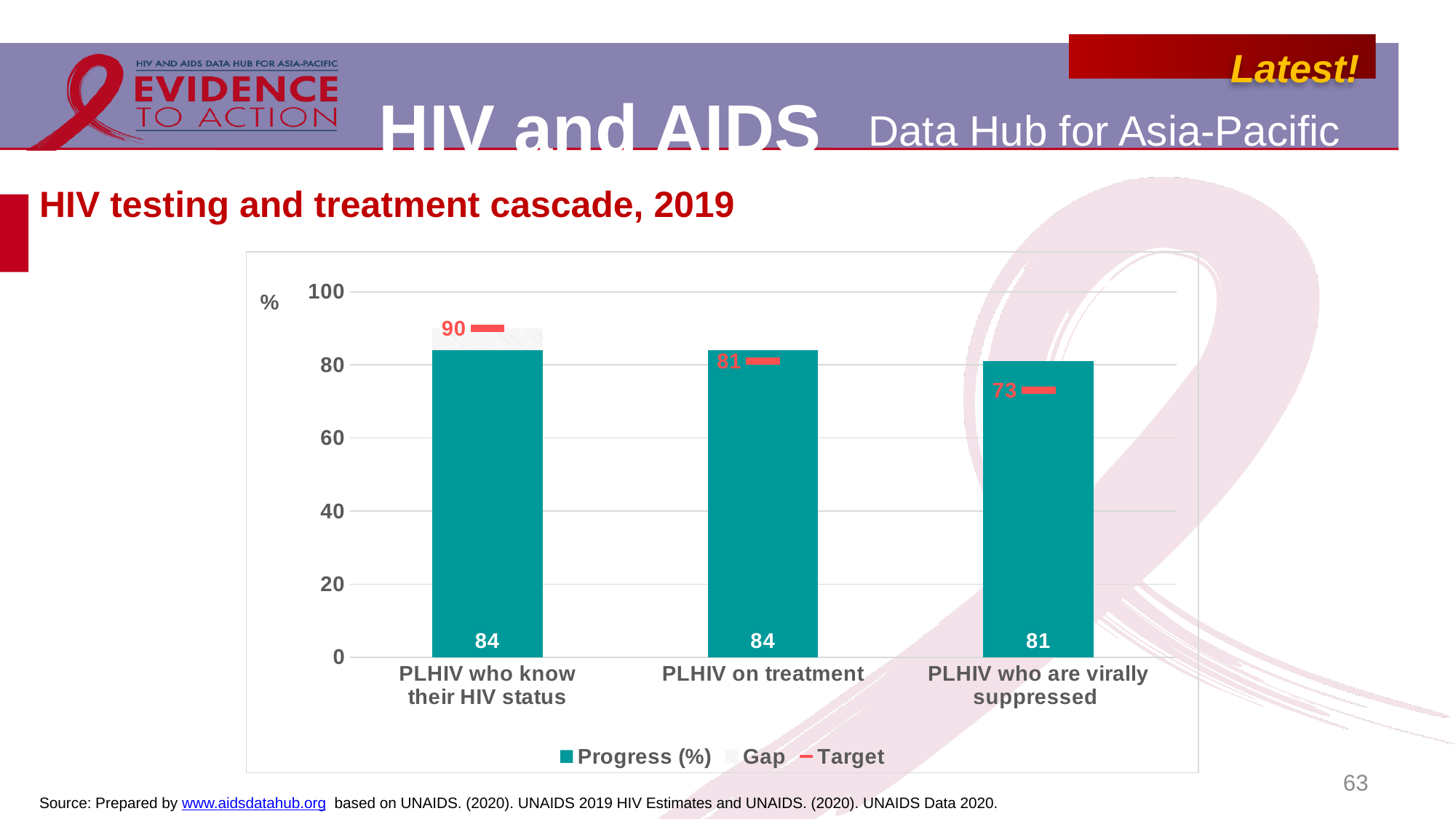
Is the Progress (%) value for PLHIV on treatment larger or smaller than its Target value? larger What kind of chart is shown on the slide? bar chart What is the Target value shown for PLHIV who know their HIV status? 90 What is the Progress (%) value for PLHIV who are virally suppressed? 81 What is the difference between the Progress (%) value for PLHIV on treatment and for PLHIV who are virally suppressed? 3 How many entries does the legend list? 3 Which category has the lowest Progress (%) value? PLHIV who are virally suppressed What is the Progress (%) value for PLHIV who know their HIV status? 84 What is the difference between the Target and the Progress (%) value for PLHIV who know their HIV status? 6 What is the Target value shown for PLHIV who are virally suppressed? 73 How many categories are shown on the x axis? 3 What is the title of the chart? HIV testing and treatment cascade, 2019